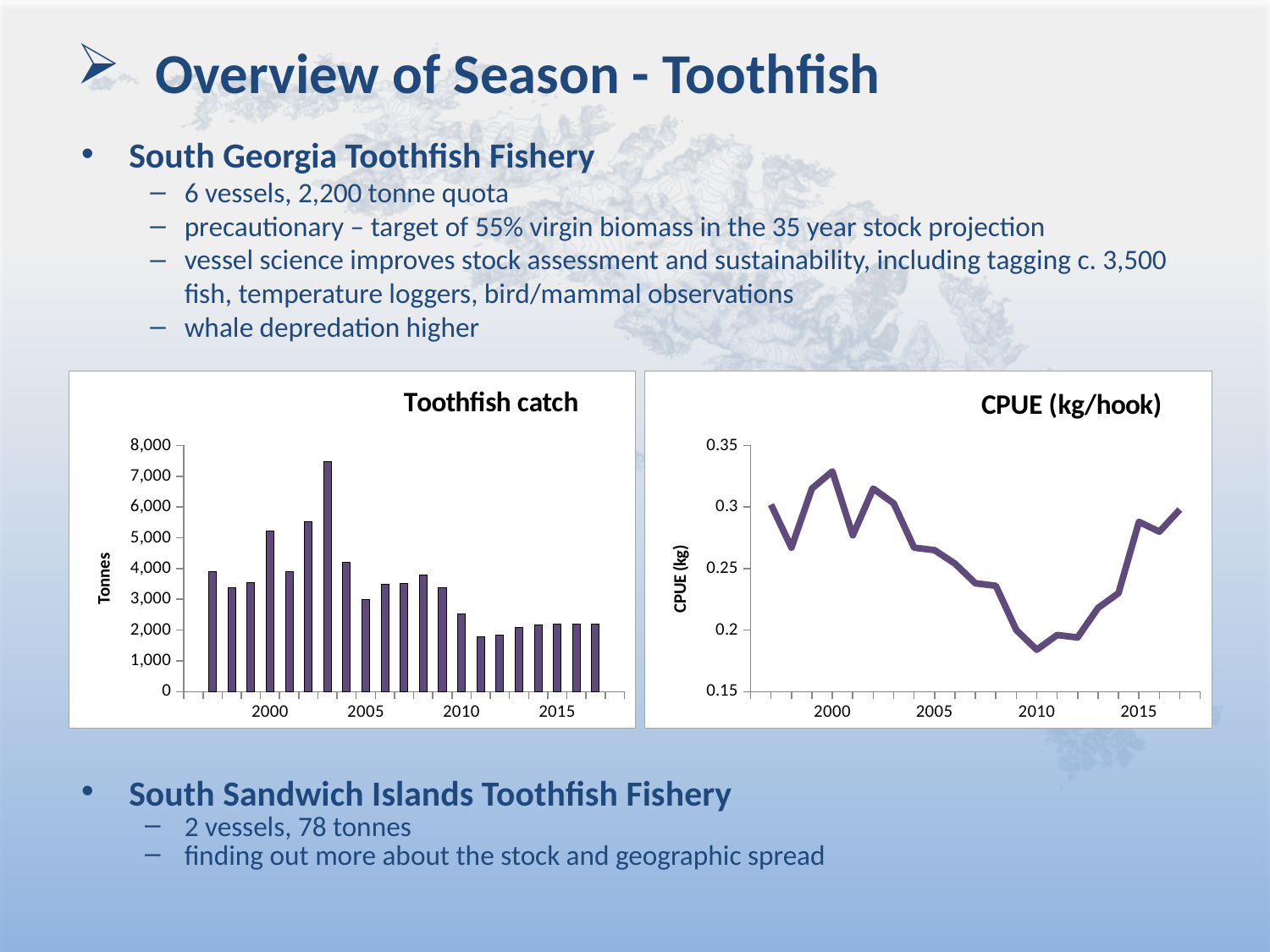
In the "CPUE (kg/hook)" chart, does the CPUE rise or fall between 2003 and 2010? fall In the "Toothfish catch" chart, which year has the highest catch? 2003 In the "Toothfish catch" chart, is the value for 2003 greater or less than 7,000? greater What is the y-axis title of the "Toothfish catch" chart? Tonnes How many bars are plotted in the "Toothfish catch" chart? 21 In the "Toothfish catch" chart, is the value for 2000 greater or less than 5,000? greater In the "Toothfish catch" chart, which is larger, the catch in 2002 or the catch in 2005? 2002 What kind of chart is the "Toothfish catch" chart? bar chart What kind of chart is the "CPUE (kg/hook)" chart? line chart In the "CPUE (kg/hook)" chart, which year has the lowest CPUE? 2010 In the "Toothfish catch" chart, is the value for 2010 greater or less than 3,000? less